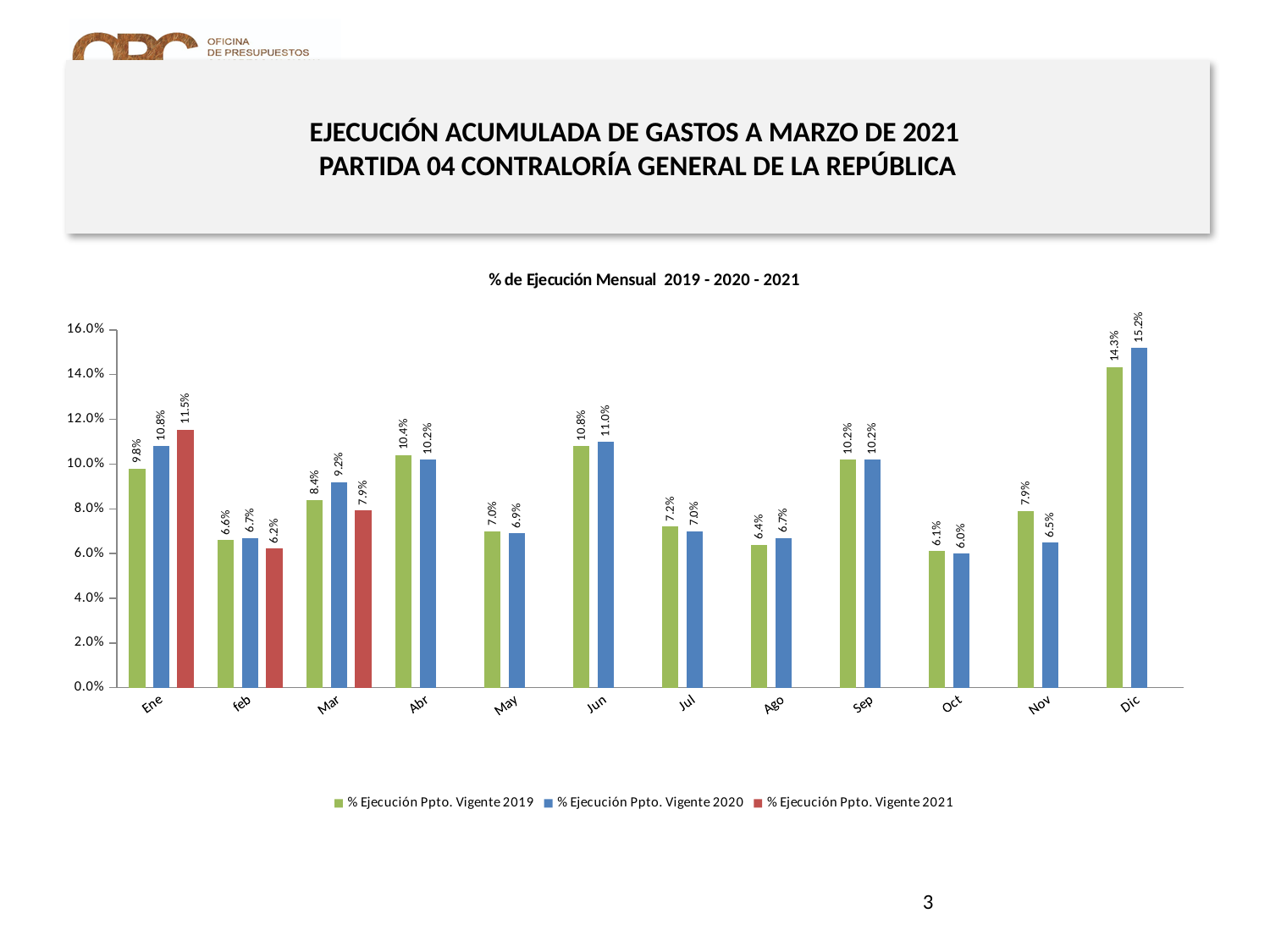
What is the value for % Ejecución Ppto. Vigente 2021 in Ene? 11.5% Which is larger in Mar: the 2019 value or the 2021 value? 2019 How many months are shown on the x axis? 12 What is the value for % Ejecución Ppto. Vigente 2019 in Dic? 14.3% What colour are the bars for % Ejecución Ppto. Vigente 2021? Red What is the difference between the 2020 and 2019 values in Ene? 1.0% Which month has the highest value for % Ejecución Ppto. Vigente 2020? Dic How many series does the legend list? 3 Which month has the lowest value for % Ejecución Ppto. Vigente 2019? Oct What kind of chart is shown? Bar chart What is the value for % Ejecución Ppto. Vigente 2020 in Mar? 9.2% What is the title of the chart? % de Ejecución Mensual 2019 - 2020 - 2021